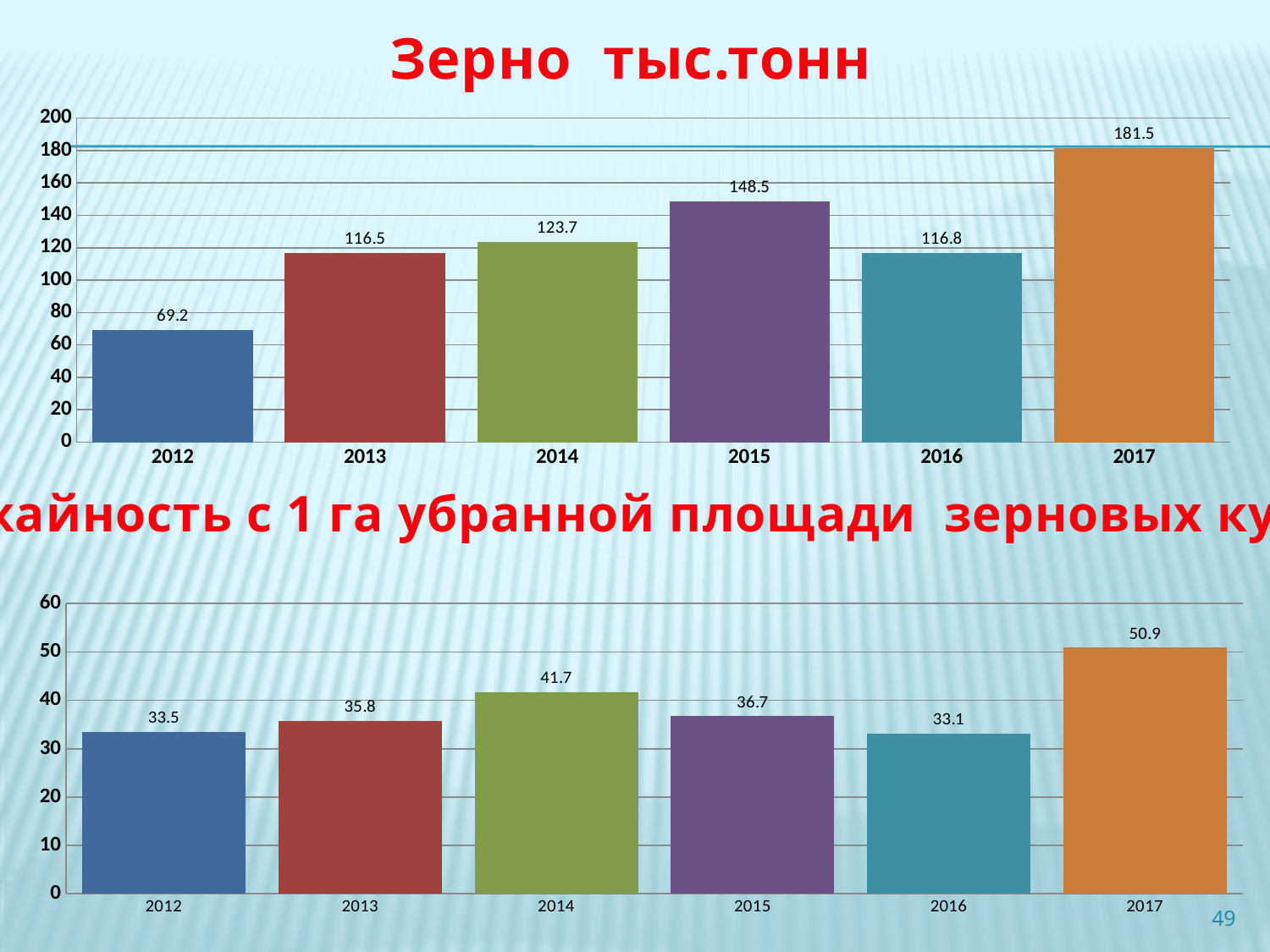
In the bottom chart, what is the value for 2014? 41.7 In the bottom chart, what is the difference between the values for 2017 and 2016? 17.8 In the bottom chart, which year has the lowest value? 2016 In the top chart titled "Зерно тыс.тонн", which is larger, the value for 2014 or the value for 2016? 2014 In the top chart titled "Зерно тыс.тонн", how many years are shown on the x axis? 6 In the top chart titled "Зерно тыс.тонн", what is the difference between the values for 2017 and 2012? 112.3 In the top chart titled "Зерно тыс.тонн", which year has the lowest value? 2012 In the top chart titled "Зерно тыс.тонн", what is the value for 2015? 148.5 What kind of chart is the top chart titled "Зерно тыс.тонн"? Bar chart In the bottom chart, which year has the highest value? 2017 In the bottom chart, is the value for 2017 greater or less than 50? greater In the top chart titled "Зерно тыс.тонн", which year has the highest value? 2017